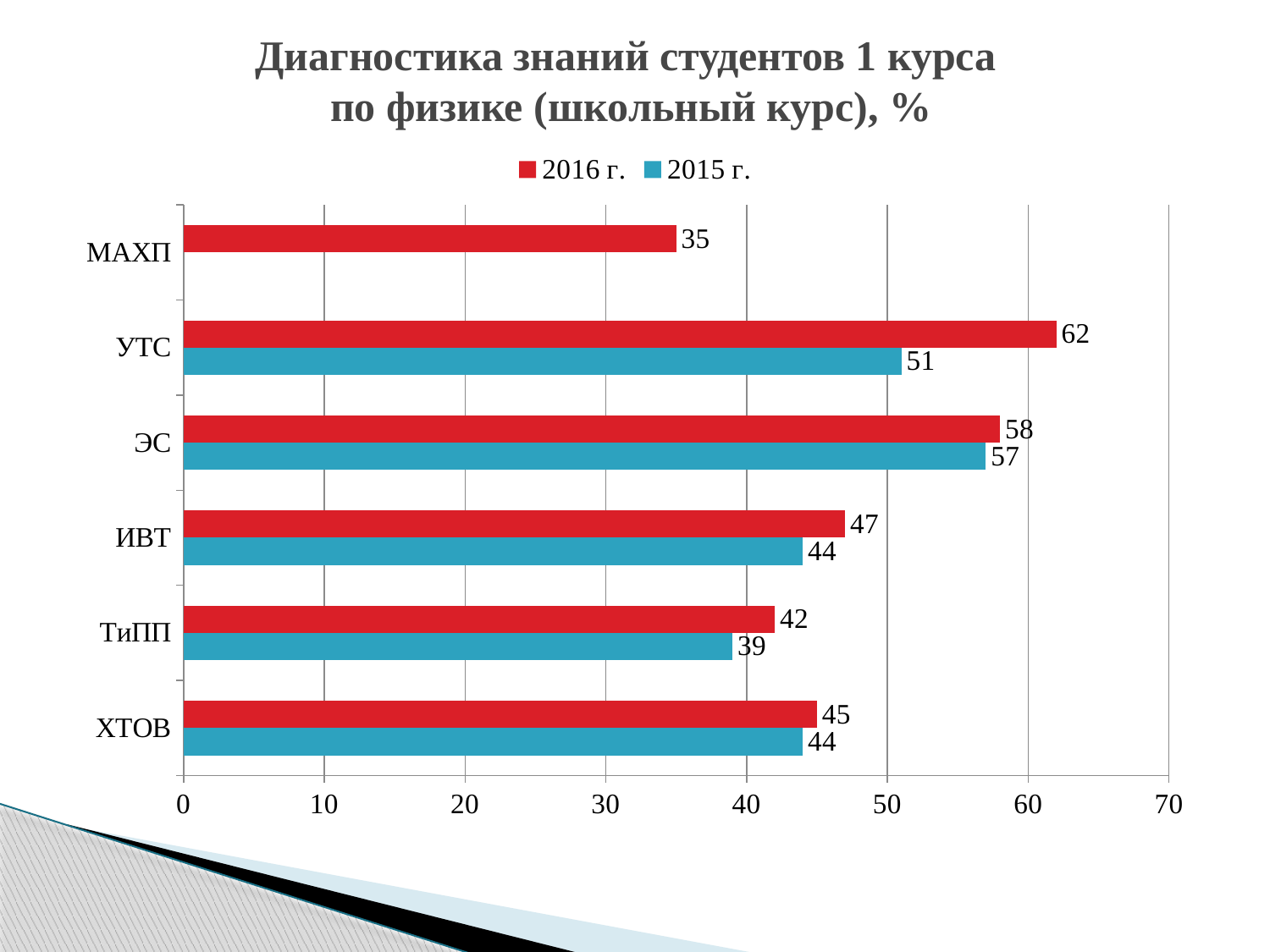
Which category has the lowest value in the 2015 г. series? ТиПП Which category has the highest value in the 2016 г. series? УТС Which is larger for ИВТ: the 2016 г. value or the 2015 г. value? 2016 г. Is the 2016 г. value for ТиПП greater or less than 40? greater How many categories are shown on the vertical axis? 6 What is the difference between the 2016 г. and 2015 г. values for УТС? 11 How many series does the legend list? 2 What kind of chart is shown on the slide? bar chart What is the value for ЭС in the 2015 г. series? 57 What is the value for МАХП in the 2016 г. series? 35 Which colour represents the 2015 г. series? blue What is the value for УТС in the 2016 г. series? 62